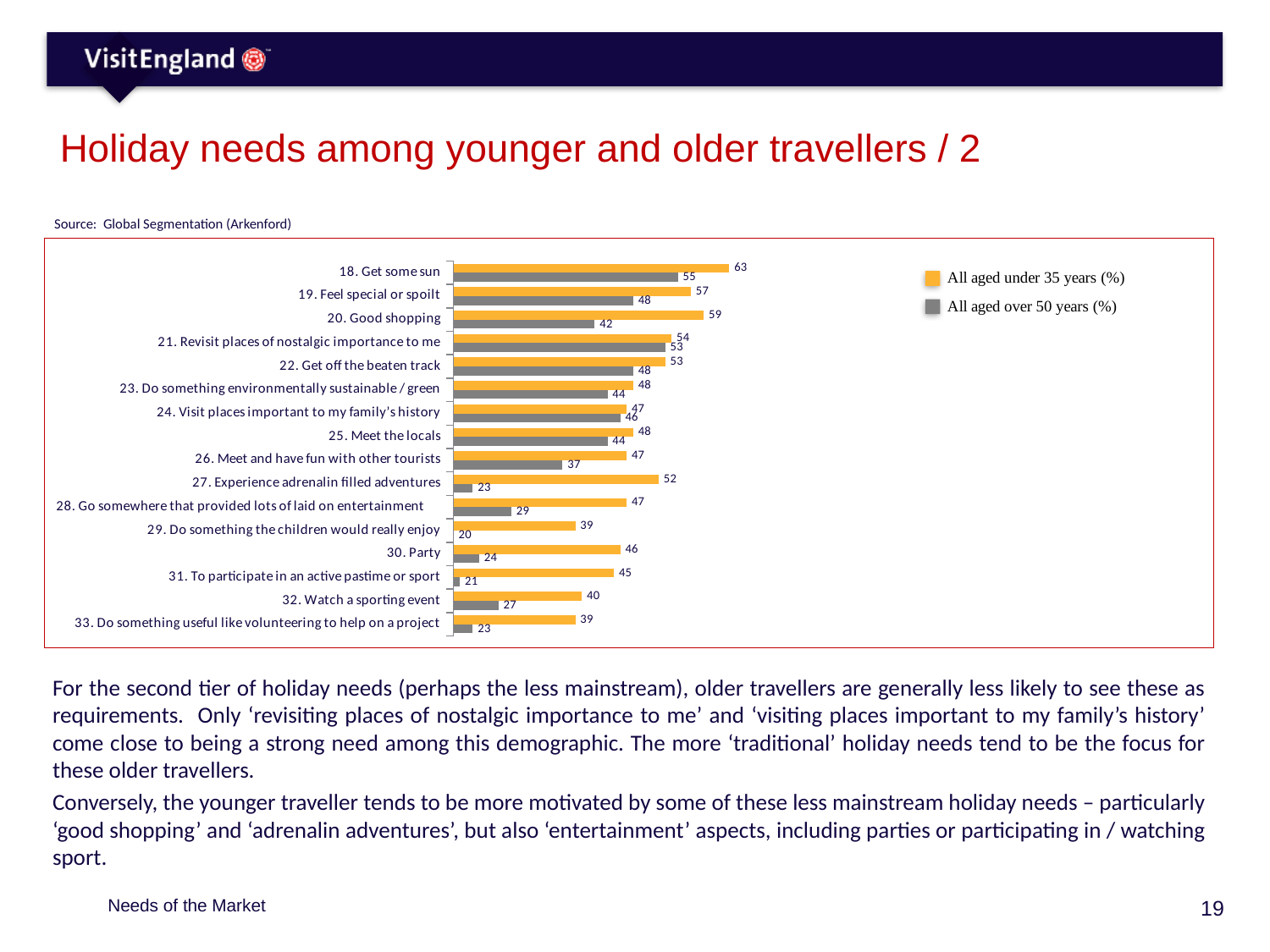
Which category has the highest value for 'All aged under 35 years (%)'? 18. Get some sun What is the value for 'All aged under 35 years (%)' for '20. Good shopping'? 59 What is the difference between the under 35 and over 50 values for '18. Get some sun'? 8 Which colour represents 'All aged over 50 years (%)' in the chart? Grey How many categories are shown in the chart? 16 What is the value for 'All aged over 50 years (%)' for '21. Revisit places of nostalgic importance to me'? 53 For '30. Party', which series has the larger value: 'All aged under 35 years (%)' or 'All aged over 50 years (%)'? All aged under 35 years (%) How many series does the legend list? 2 What is the difference between the under 35 and over 50 values for '27. Experience adrenalin filled adventures'? 29 Which category has the lowest value for 'All aged over 50 years (%)'? 29. Do something the children would really enjoy What kind of chart is shown on the slide? Bar chart What is the value for 'All aged over 50 years (%)' for '27. Experience adrenalin filled adventures'? 23